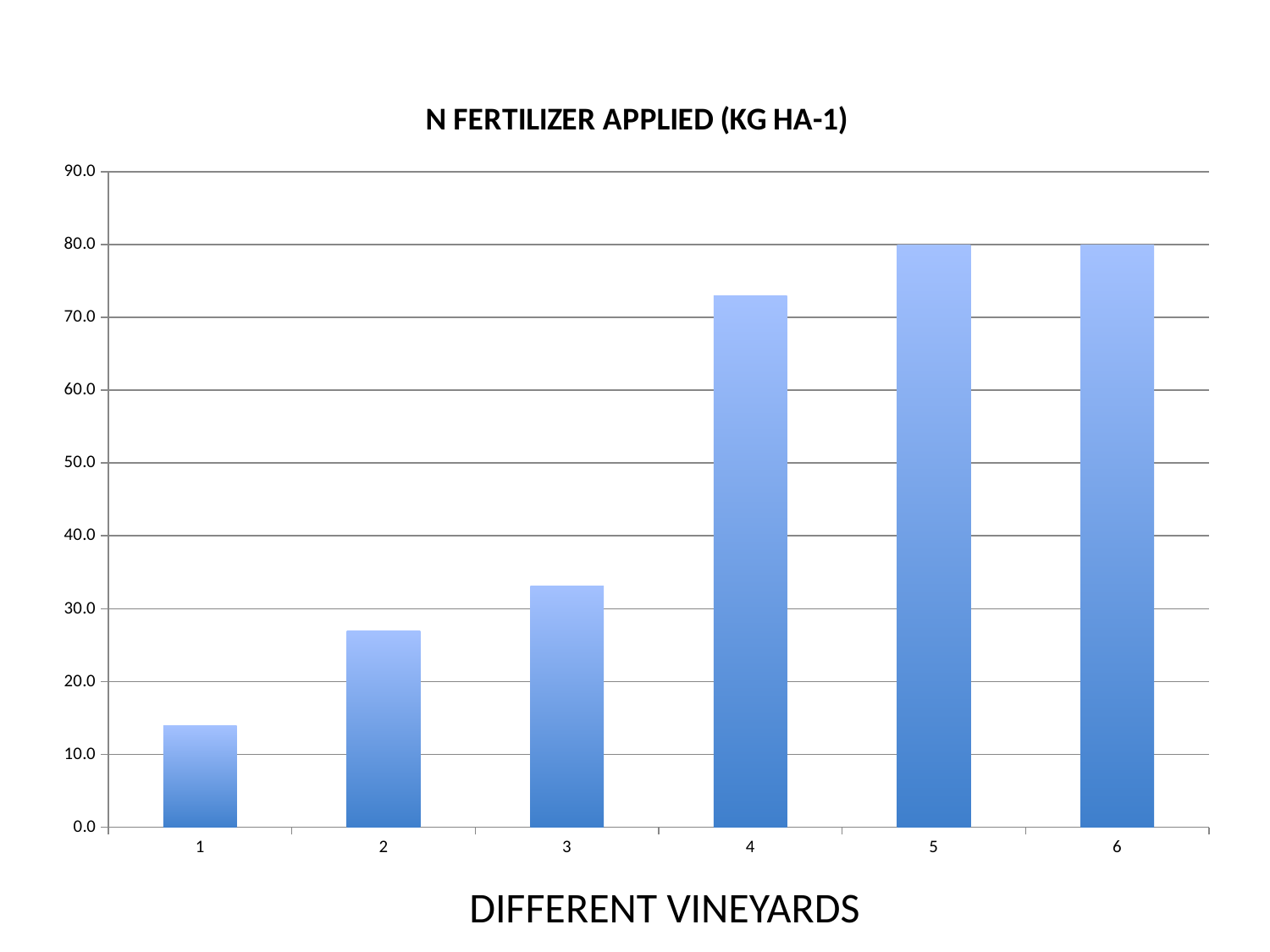
What is the label on the x axis of the chart? DIFFERENT VINEYARDS Do the values generally rise or fall from vineyard 1 to vineyard 6? rise How many vineyards are shown on the x axis? 6 Which vineyard has the lowest N fertilizer applied? 1 What is the value for vineyard 6? 80.0 What is the value for vineyard 5? 80.0 What kind of chart is shown on the slide? bar chart Is the value for vineyard 4 greater or less than 70.0? greater Is the value for vineyard 1 greater or less than 20.0? less Which has a larger value, vineyard 3 or vineyard 4? vineyard 4 What is the title of the chart? N FERTILIZER APPLIED (KG HA-1) Is the value for vineyard 2 greater or less than 30.0? less